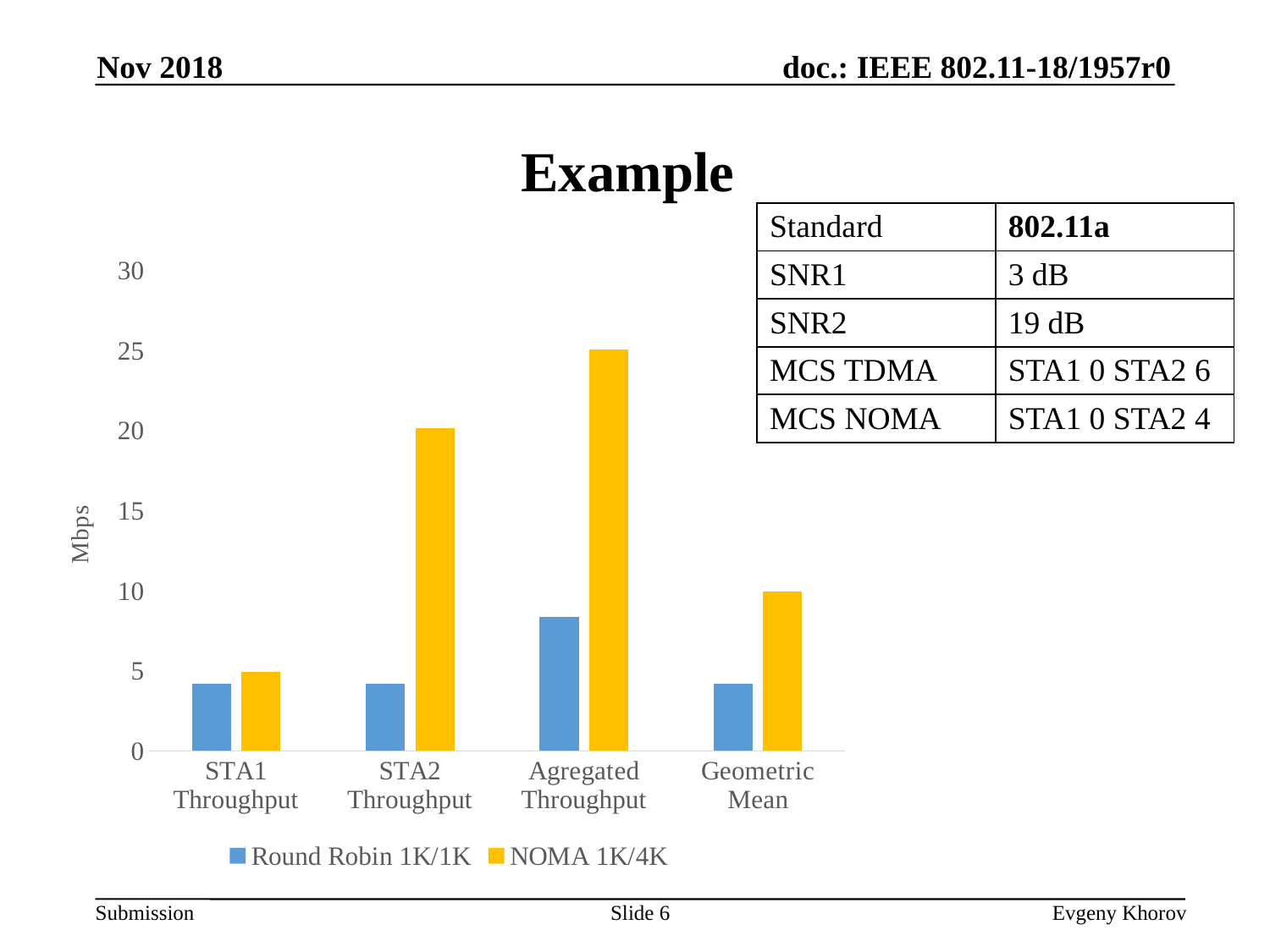
Is the NOMA 1K/4K value for Agregated Throughput greater or less than 20? greater Is the Round Robin 1K/1K value for Agregated Throughput greater or less than 10? less What kind of chart is shown on the slide? bar chart What is the label of the y axis of the chart? Mbps Which category has the highest Round Robin 1K/1K value? Agregated Throughput For STA2 Throughput, which series has the larger value, Round Robin 1K/1K or NOMA 1K/4K? NOMA 1K/4K How many categories are shown on the x axis of the chart? 4 Is the NOMA 1K/4K value for STA2 Throughput greater or less than 15? greater Which category has the highest NOMA 1K/4K value? Agregated Throughput How many series does the chart legend list? 2 What colour are the NOMA 1K/4K bars in the chart? yellow